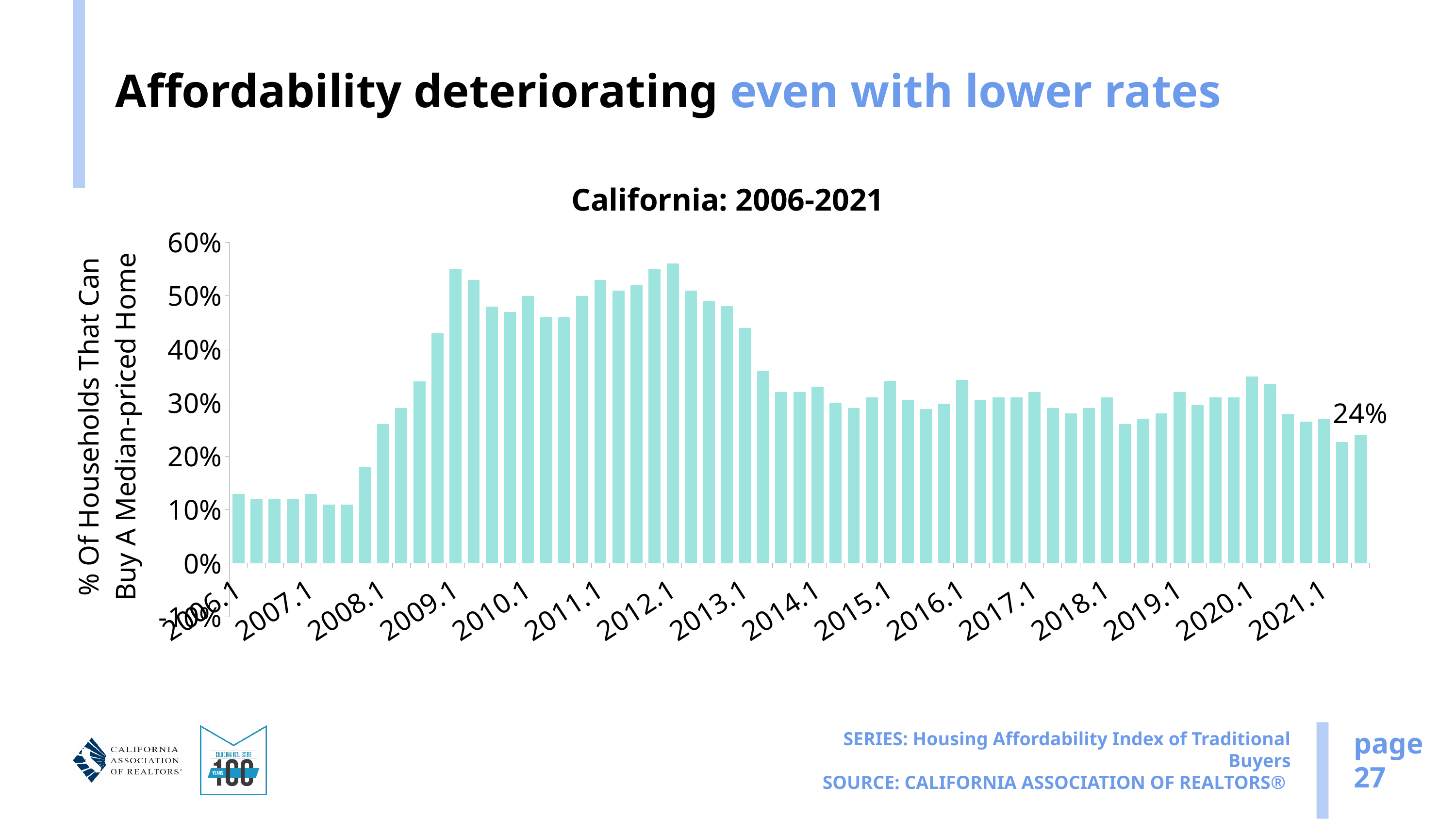
How many year labels are shown on the x axis? 16 Is the value for 2012.1 greater or less than 50%? greater What kind of chart is shown on the slide? bar chart What is the label on the vertical axis of the chart? % Of Households That Can Buy A Median-priced Home Is the value for 2021.1 greater or less than 40%? less Is the value for 2009.1 greater or less than 30%? greater What value is labelled on the last bar of the chart? 24% Which is larger, the value for 2009.1 or the value for 2021.1? 2009.1 Which is larger, the value for 2006.1 or the value for 2012.1? 2012.1 What is the title of the chart? California: 2006-2021 Between 2006.1 and 2009.1, do the values generally rise or fall? rise